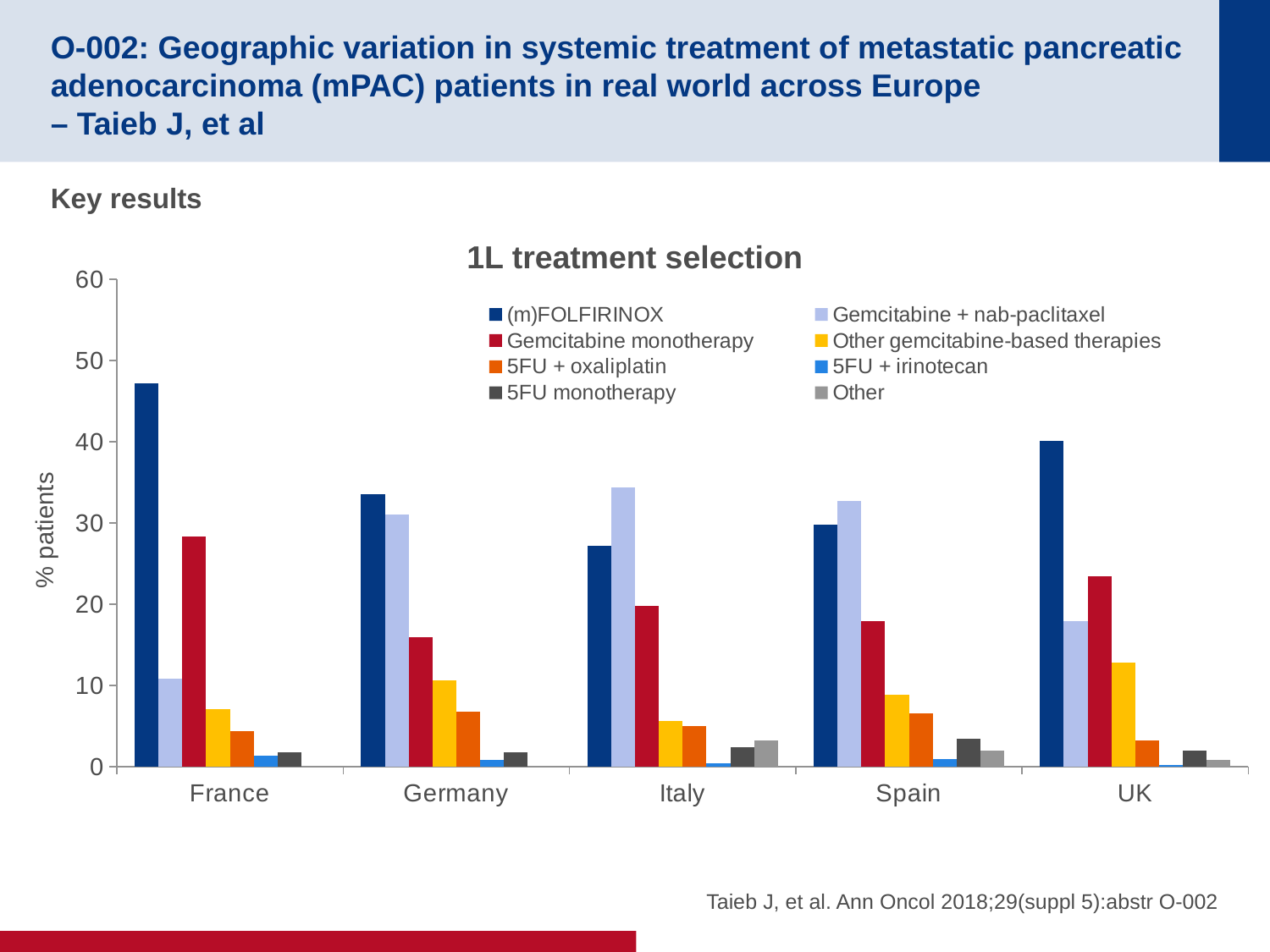
Is the value for Gemcitabine monotherapy in the UK greater or less than 20? greater Is the value for (m)FOLFIRINOX in France greater or less than 40? greater Which country has the lowest value for Gemcitabine + nab-paclitaxel? France How many treatment series does the legend list? 8 In the UK, which is larger: Gemcitabine monotherapy or Gemcitabine + nab-paclitaxel? Gemcitabine monotherapy Which country has the highest value for Other gemcitabine-based therapies? UK In Italy, which is larger: Gemcitabine + nab-paclitaxel or (m)FOLFIRINOX? Gemcitabine + nab-paclitaxel Which country has the highest value for (m)FOLFIRINOX? France What is the title of the chart? 1L treatment selection How many countries are shown on the x axis of the chart? 5 Is the value for (m)FOLFIRINOX in Italy greater or less than 30? less What kind of chart is shown on the slide? bar chart